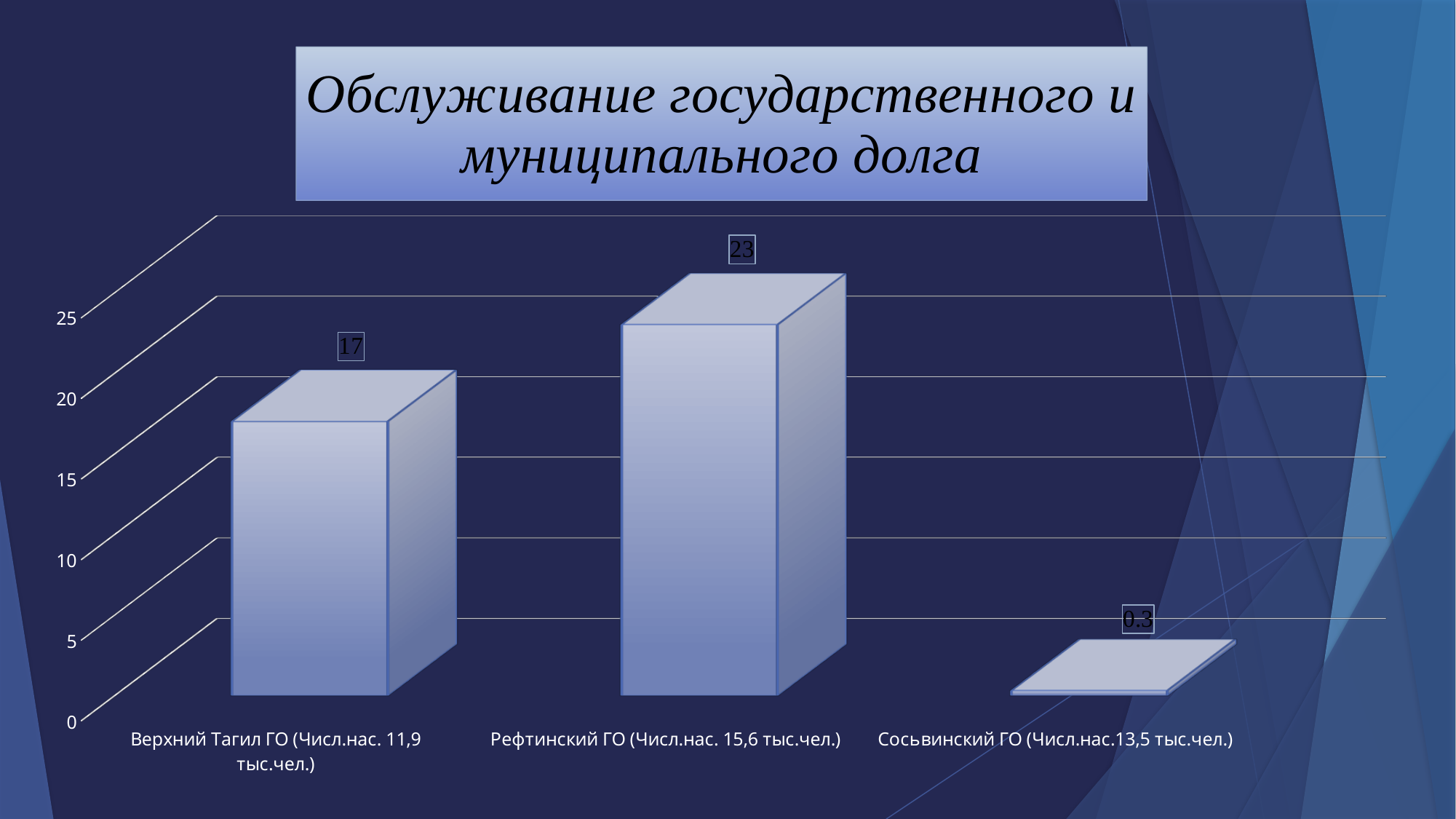
Which category has the lowest value? Сосьвинский ГО Is the value for Верхний Тагил ГО greater or less than 20? less Is the value for Рефтинский ГО greater or less than 20? greater What is the value for Сосьвинский ГО? 0.3 What is the title of the slide? Обслуживание государственного и муниципального долга What is the value for Верхний Тагил ГО? 17 What kind of chart is shown on the slide? bar chart Which is larger, the value for Верхний Тагил ГО or the value for Сосьвинский ГО? Верхний Тагил ГО How many categories are shown in the chart? 3 Which category has the highest value? Рефтинский ГО What is the difference between the values for Рефтинский ГО and Верхний Тагил ГО? 6 What is the value for Рефтинский ГО? 23